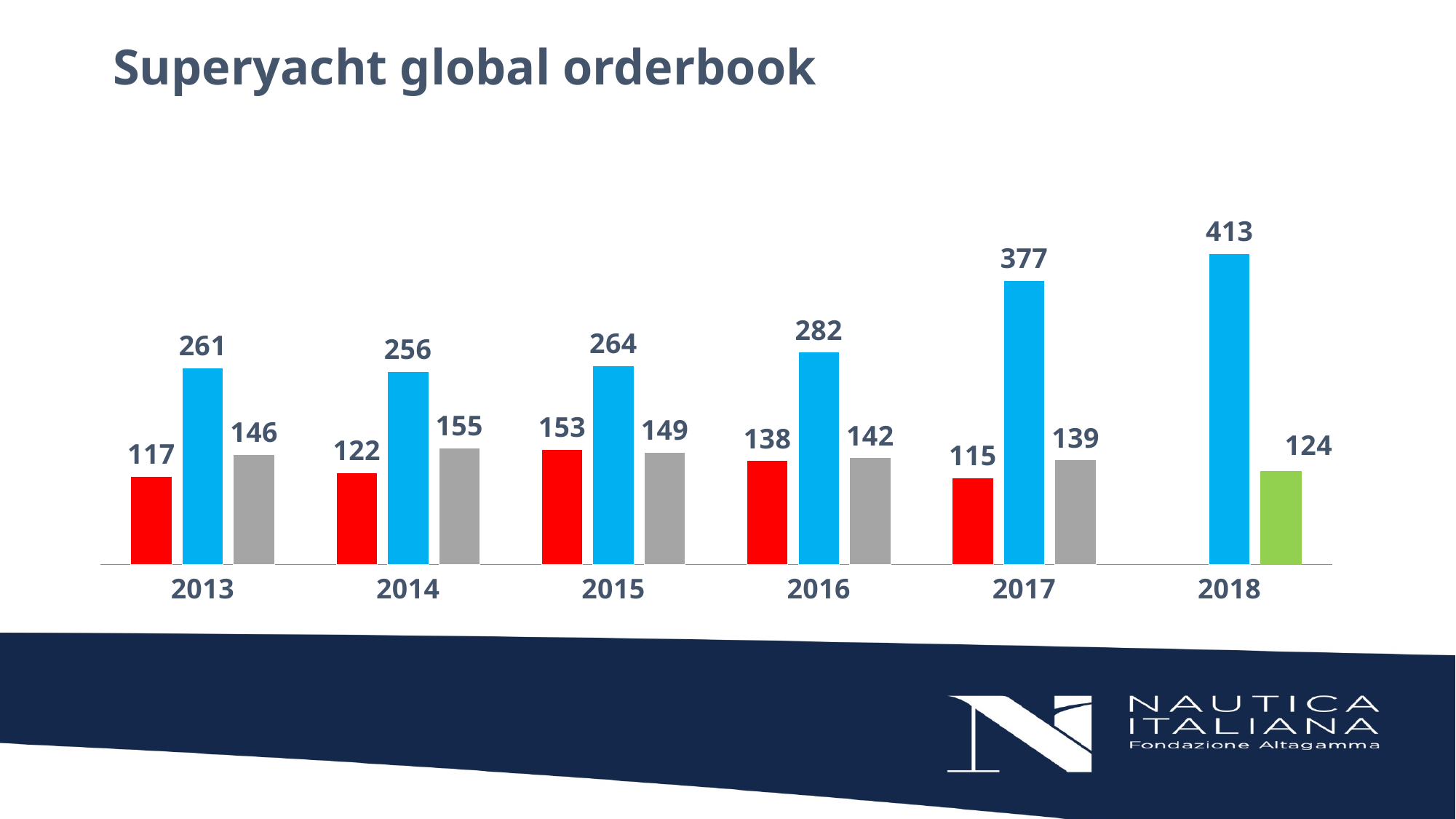
Do the blue bar values rise or fall from 2015 to 2018? rise What is the value of the green bar for 2018? 124 What is the value of the red bar for 2015? 153 What is the difference between the blue bar values for 2017 and 2016? 95 What is the value of the grey bar for 2014? 155 What is the title of the chart? Superyacht global orderbook In which year is the blue bar highest? 2018 In which year is the red bar lowest? 2017 What kind of chart is shown on the slide? bar chart Which is larger for 2015, the red bar or the grey bar? the red bar How many years are shown on the x axis? 6 What is the value of the blue bar for 2018? 413